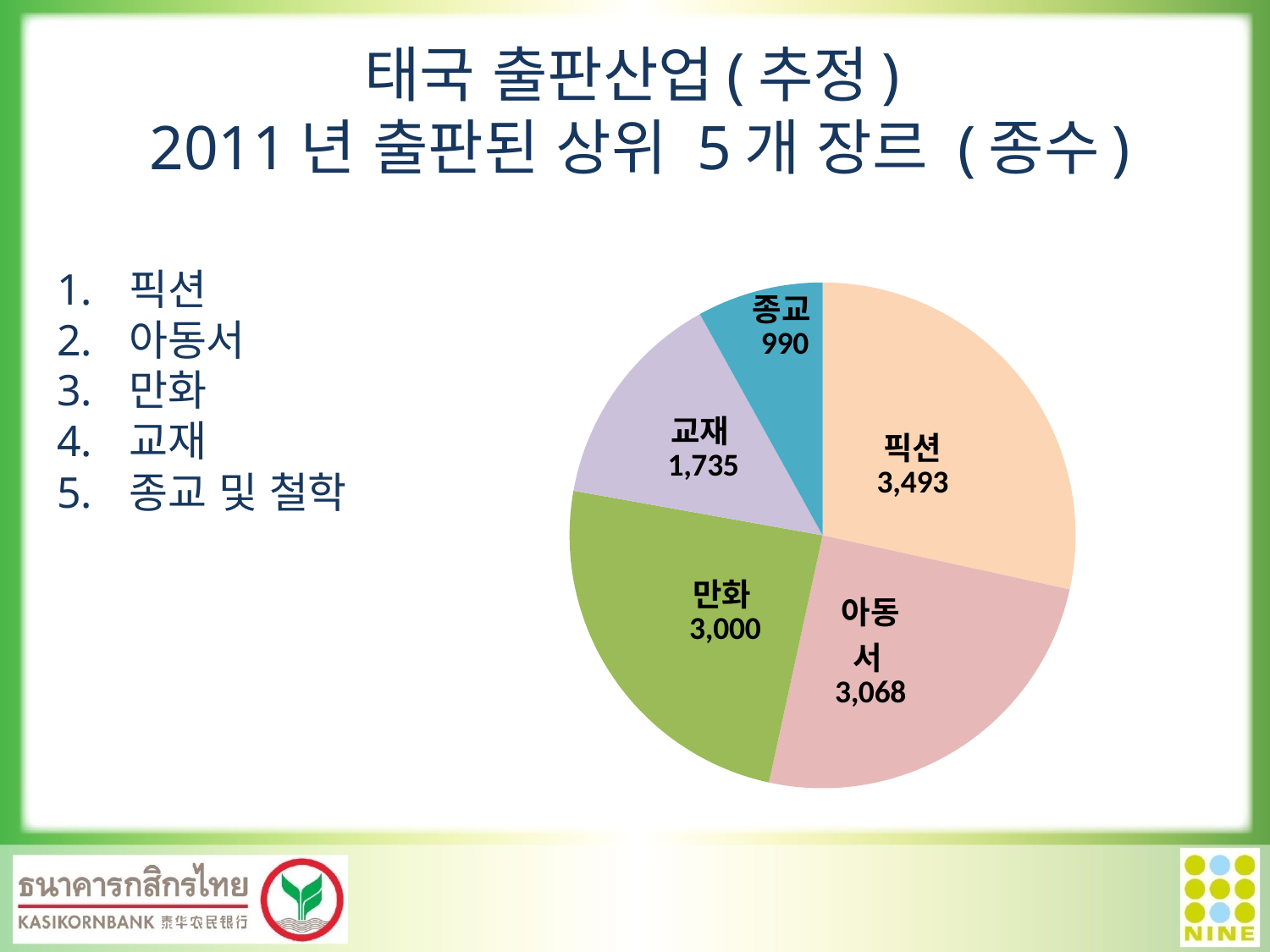
What kind of chart is shown on the slide? pie chart What is the value shown for 종교 in the pie chart? 990 Which category has the smallest slice in the pie chart? 종교 What is the difference between the values for 만화 and 교재? 1,265 How many slices does the pie chart have? 5 Which is larger, the value for 아동서 or the value for 만화? 아동서 Which category has the largest slice in the pie chart? 픽션 What is the difference between the values for 픽션 and 아동서? 425 What is the value shown for 교재 in the pie chart? 1,735 What is the value shown for 아동서 in the pie chart? 3,068 What is the value shown for 픽션 in the pie chart? 3,493 What colour is the 만화 slice in the pie chart? green